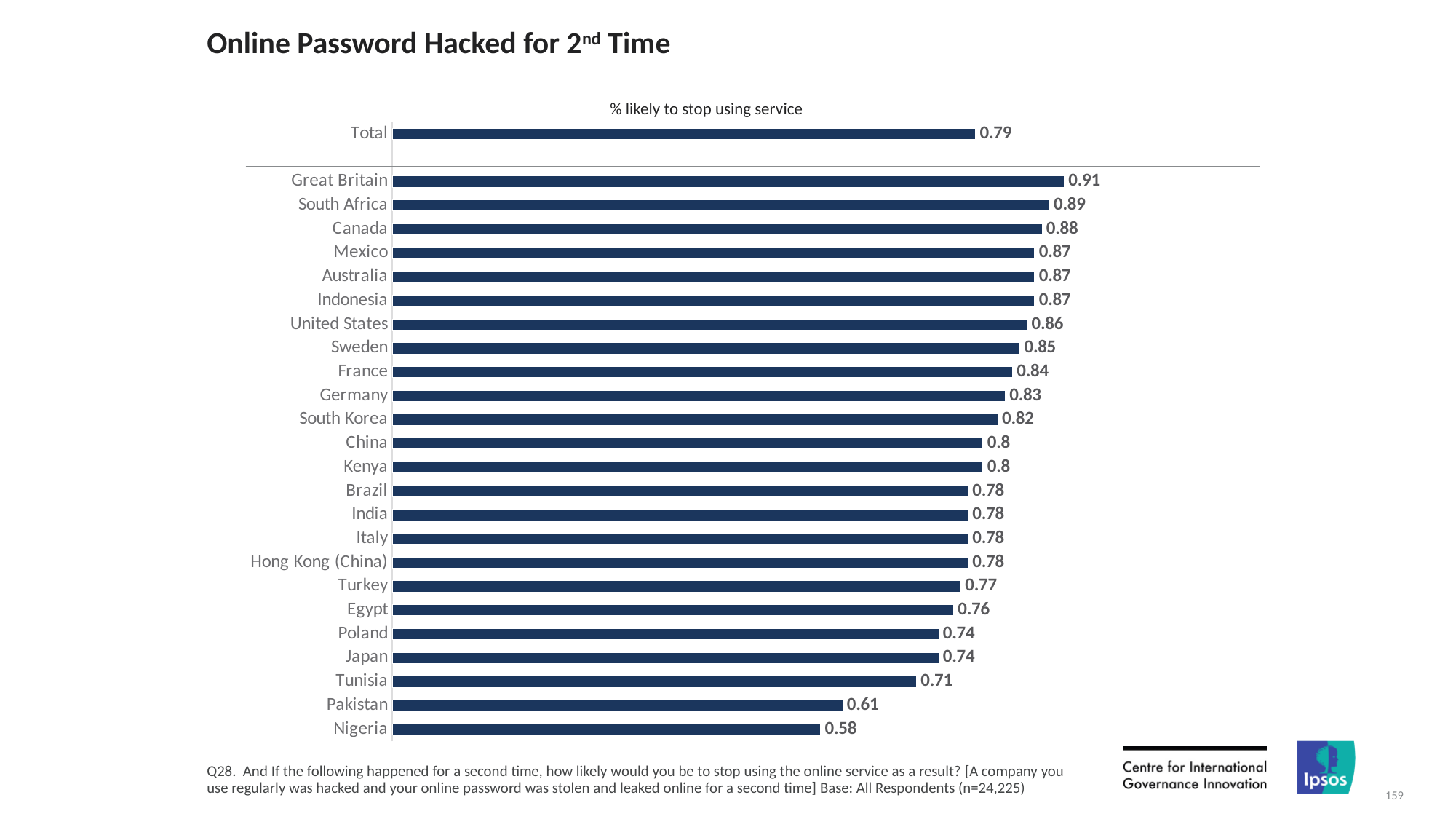
Which country has the lowest value? Nigeria How many countries are listed below the Total bar? 24 What kind of chart is shown on the slide? Bar chart Which country has the highest value? Great Britain What is the chart's subtitle above the bars? % likely to stop using service What is the difference between the values for Great Britain and Nigeria? 0.33 What is the value for Nigeria? 0.58 Which is larger, the value for Sweden or the value for Tunisia? Sweden What is the value for Great Britain? 0.91 What is the difference between the values for Canada and Pakistan? 0.27 What is the value for Japan? 0.74 What is the value for Total? 0.79